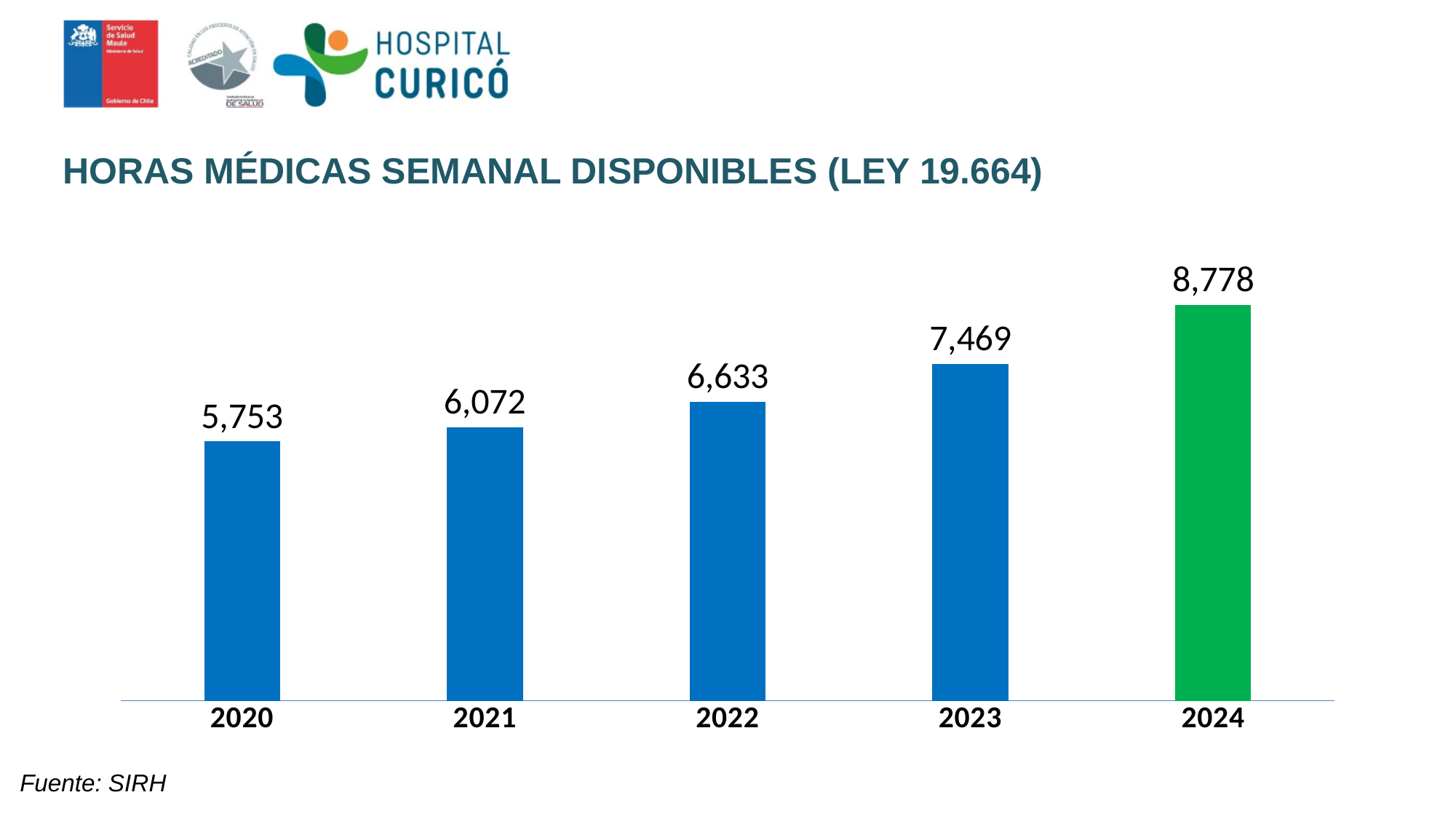
What is the value for 2024? 8,778 Which bar is coloured green rather than blue? 2024 What kind of chart is shown on the slide? Bar chart What is the value for 2022? 6,633 What is the difference between the values for 2021 and 2020? 319 Which is larger, the value for 2022 or the value for 2023? 2023 How many years are shown on the chart? 5 What is the difference between the values for 2024 and 2023? 1,309 Which year has the lowest value? 2020 Which year has the highest value? 2024 What is the value for 2020? 5,753 Do the values rise or fall from 2020 to 2024? Rise